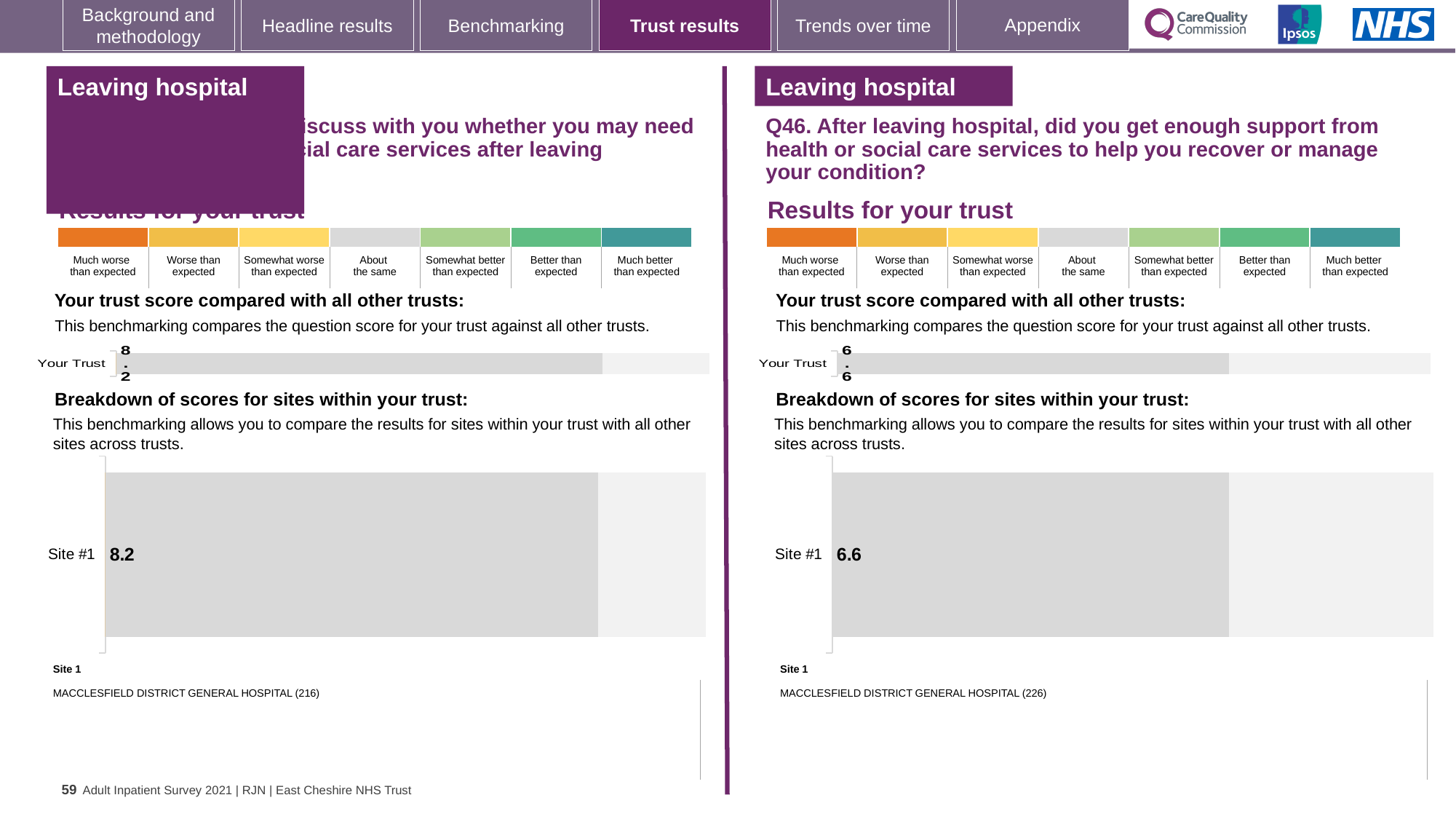
Which hospital is listed as Site 1 on the right-hand side of the slide (Q46)? MACCLESFIELD DISTRICT GENERAL HOSPITAL (226) On the right-hand side of the slide (Q46), what is the score shown for Your Trust? 6.6 On the left-hand side of the slide, what is the score shown for Your Trust? 8.2 On the right-hand side of the slide (Q46), is the Site #1 score greater or less than the Site #1 score on the left-hand side? less How many sites are shown in the breakdown of scores chart on the right-hand side of the slide (Q46)? 1 Which hospital is listed as Site 1 on the left-hand side of the slide? MACCLESFIELD DISTRICT GENERAL HOSPITAL (216) On the left-hand side of the slide, what score is shown for Site #1 in the breakdown of scores for sites within your trust? 8.2 Which is larger: the Your Trust score on the left-hand side of the slide or the Your Trust score on the right-hand side (Q46)? Left-hand side (8.2) What is the difference between the Site #1 score on the left-hand side of the slide and the Site #1 score on the right-hand side (Q46)? 1.6 On the right-hand side of the slide (Q46), what score is shown for Site #1 in the breakdown of scores for sites within your trust? 6.6 What type of chart is used to show the Site #1 score on the right-hand side of the slide (Q46)? Bar chart How many sites are shown in the breakdown of scores chart on the left-hand side of the slide? 1